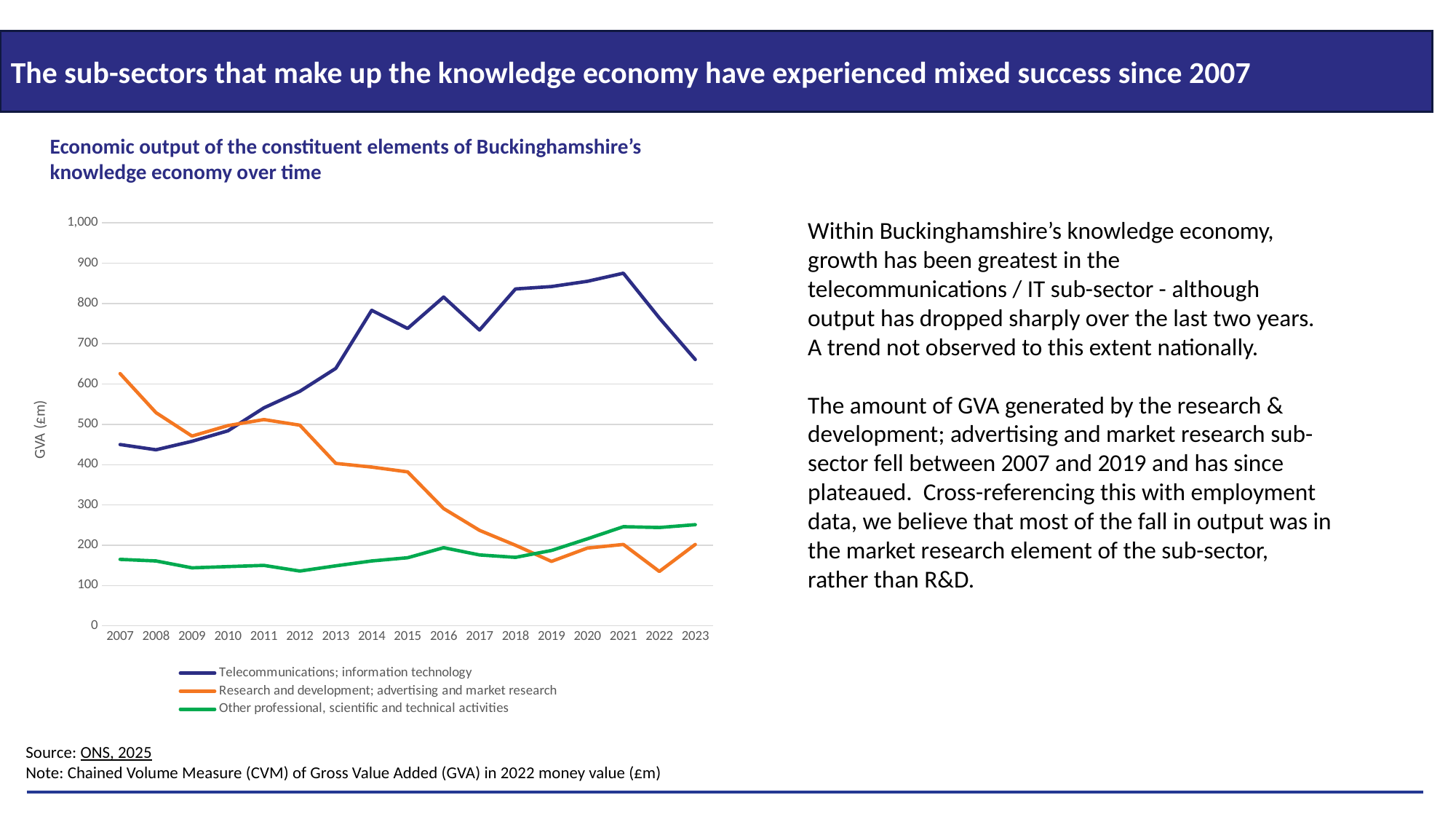
In which year does the Telecommunications; information technology series reach its highest value? 2021 Is the value for Telecommunications; information technology in 2023 greater or less than 700? less What kind of chart is shown on the slide? line chart Is the value for Telecommunications; information technology in 2021 greater or less than 800? greater In 2023, which series has the larger value: Telecommunications; information technology or Other professional, scientific and technical activities? Telecommunications; information technology How many years are shown along the x axis of the chart? 17 In which year does the Research and development; advertising and market research series reach its lowest value? 2022 What is the label on the chart's y axis? GVA (£m) Does the Research and development; advertising and market research series rise or fall between 2007 and 2019? fall In 2007, which series has the larger value: Telecommunications; information technology or Research and development; advertising and market research? Research and development; advertising and market research Is the value for Research and development; advertising and market research in 2007 greater or less than 600? greater How many series does the chart's legend list? 3